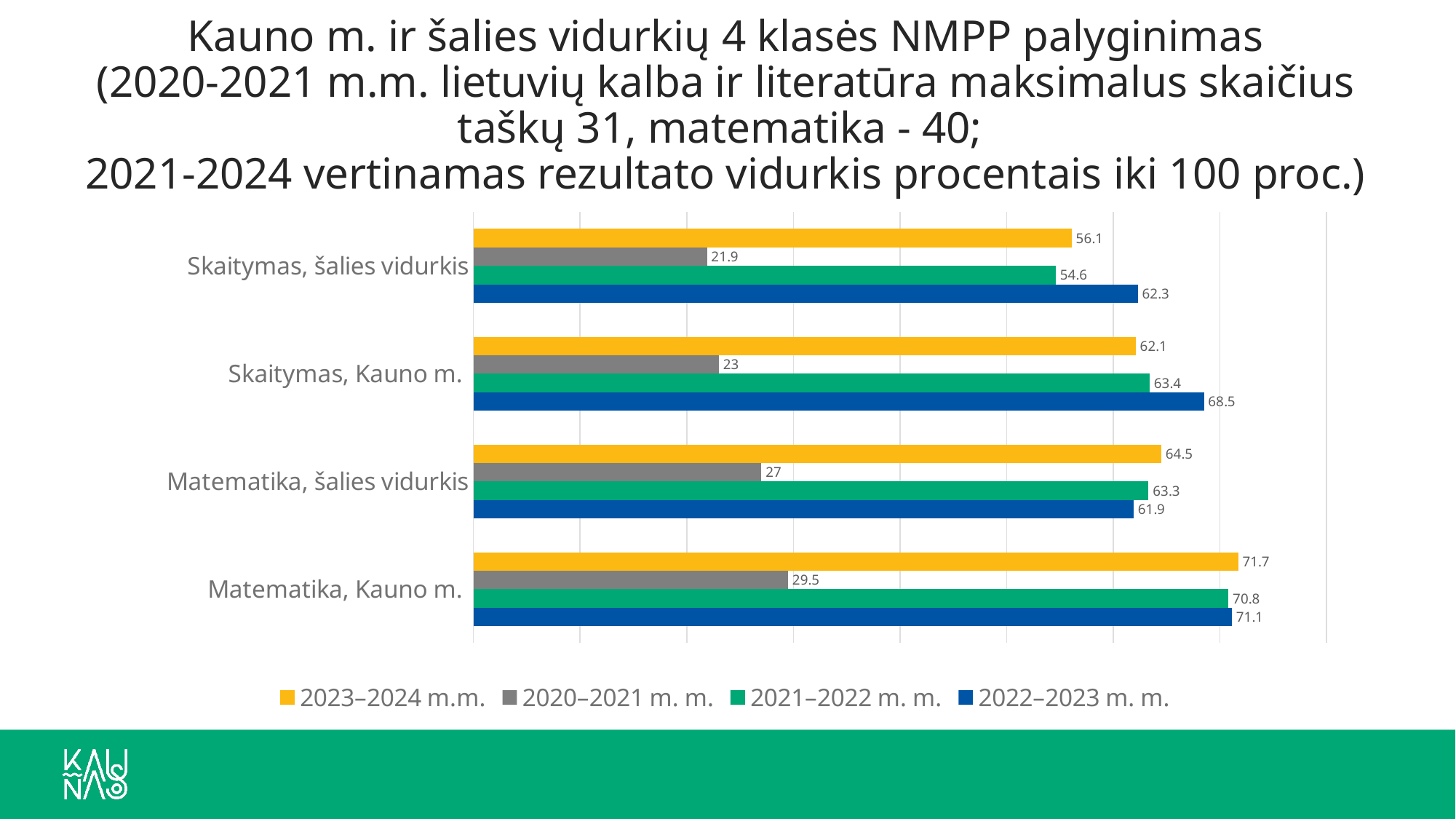
Which category has the lowest value in the 2020–2021 m. m. series? Skaitymas, šalies vidurkis Which category has the highest value in the 2022–2023 m. m. series? Matematika, Kauno m. What kind of chart is shown on the slide? Bar chart How many categories are shown on the chart? 4 What is the difference between the 2022–2023 m. m. values for Skaitymas, Kauno m. and Skaitymas, šalies vidurkis? 6.2 Which is larger for Matematika, šalies vidurkis: the 2023–2024 m.m. value or the 2022–2023 m. m. value? 2023–2024 m.m. Which colour represents the 2020–2021 m. m. series in the legend? Grey What is the value for Matematika, Kauno m. in the 2023–2024 m.m. series? 71.7 How many series does the legend list? 4 What is the value for Skaitymas, šalies vidurkis in the 2020–2021 m. m. series? 21.9 What is the value for Matematika, šalies vidurkis in the 2021–2022 m. m. series? 63.3 What is the value for Skaitymas, Kauno m. in the 2022–2023 m. m. series? 68.5